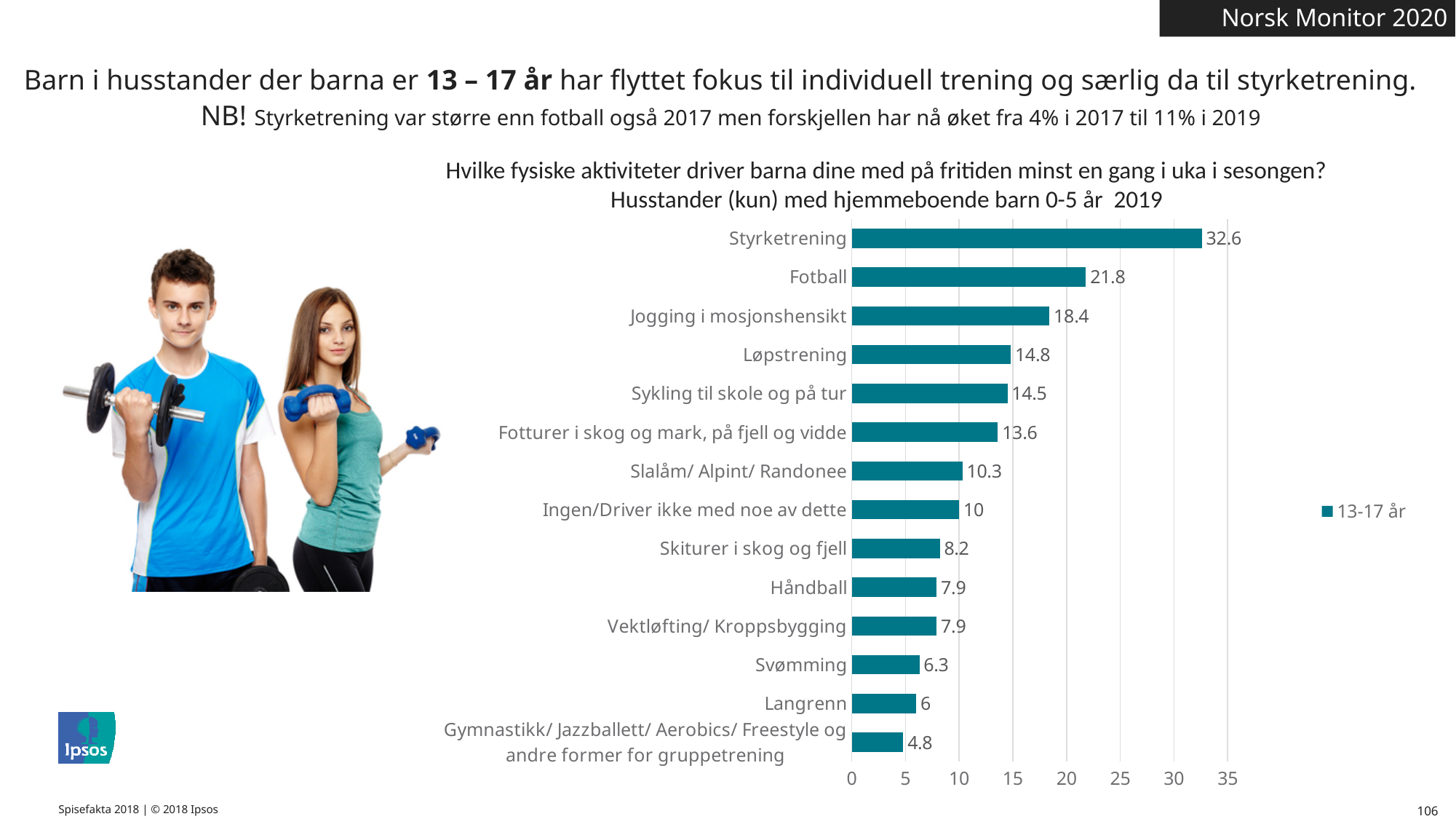
What is the value for Sykling til skole og på tur? 14.5 How many series does the legend list? 1 What series name is shown in the legend? 13-17 år What is the difference between the values for Styrketrening and Fotball? 10.8 What is the value for Fotball? 21.8 What kind of chart is shown on the slide? bar chart Which category has the lowest value? Gymnastikk/ Jazzballett/ Aerobics/ Freestyle og andre former for gruppetrening How many categories are shown in the chart? 14 Which category has the highest value? Styrketrening What is the value for Styrketrening? 32.6 Which is larger, the value for Jogging i mosjonshensikt or the value for Løpstrening? Jogging i mosjonshensikt Is the value for Slalåm/ Alpint/ Randonee greater or less than 15? less